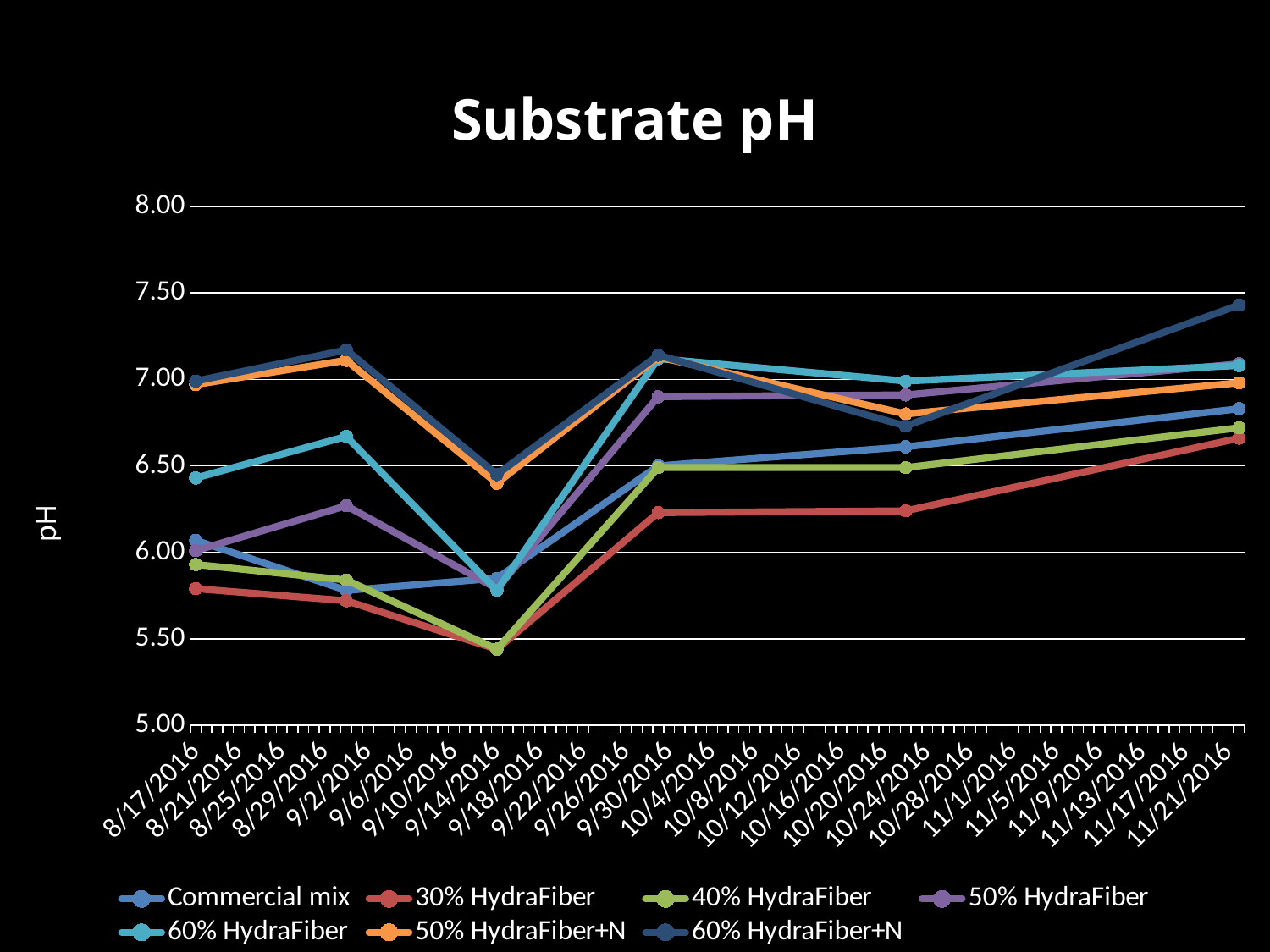
Does the 30% HydraFiber line rise or fall between 9/30/2016 and 11/21/2016? rise Is the value for Commercial mix on 9/14/2016 greater or less than 6.00? less Which series has the highest pH at the last date, 11/21/2016? 60% HydraFiber+N What kind of chart is shown on the slide? line chart What is the label on the vertical axis? pH On 8/29/2016, which is higher: 60% HydraFiber or Commercial mix? 60% HydraFiber Which series has the lowest pH at the first date, 8/17/2016? 30% HydraFiber How many series does the legend list? 7 Is the value for 60% HydraFiber+N on 11/21/2016 greater or less than 7.00? greater Is the value for 60% HydraFiber on 8/29/2016 greater or less than 6.50? greater What is the title of the chart? Substrate pH